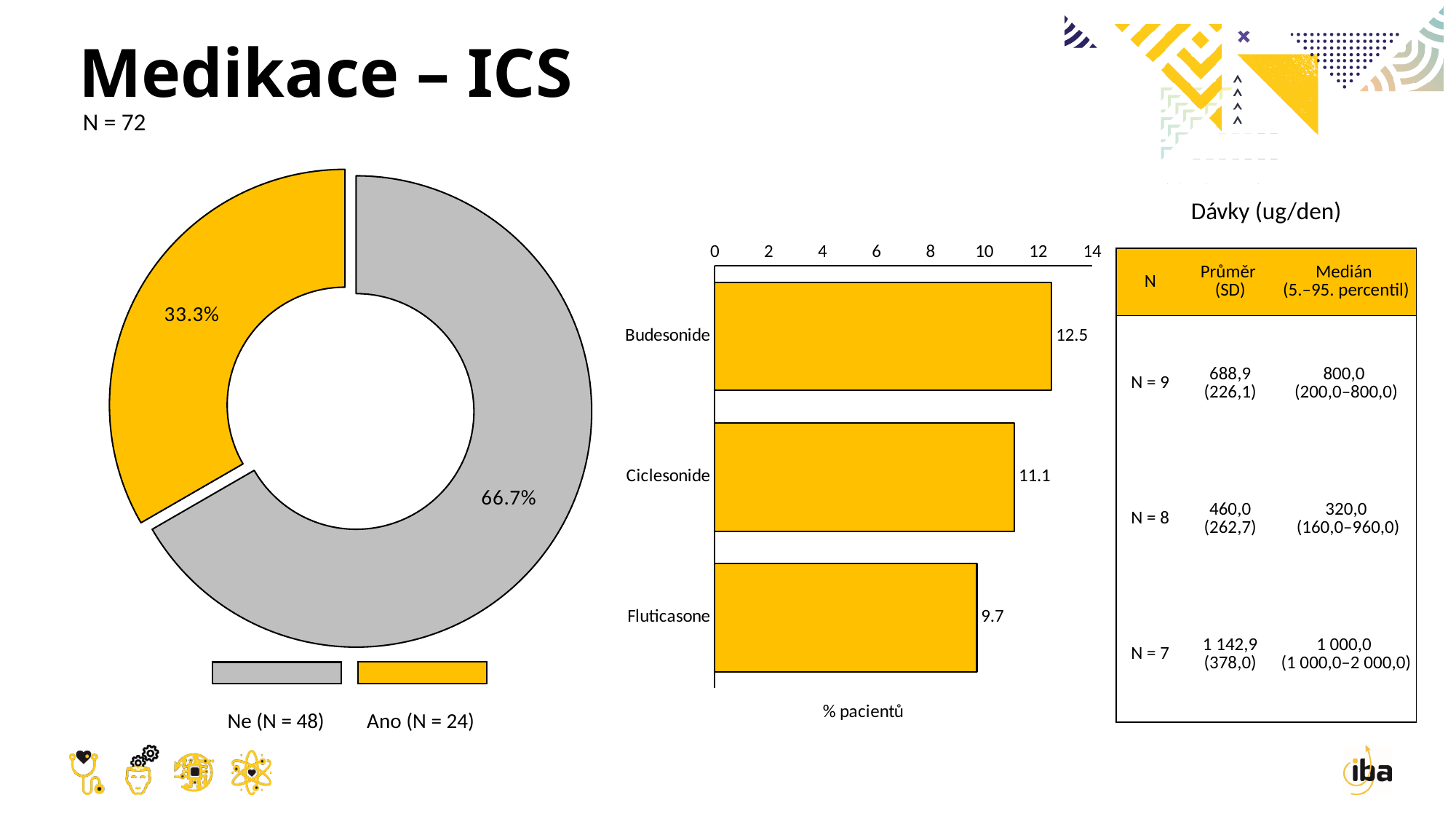
In the donut chart on the left, which slice is larger, 'Ne' or 'Ano'? Ne In the bar chart in the middle, what is the value for Fluticasone? 9.7 In the bar chart in the middle, what is the difference between the values for Budesonide and Fluticasone? 2.8 What kind of chart is the chart in the middle of the slide? Bar chart In the donut chart on the left, what percentage is shown for the 'Ano (N = 24)' slice? 33.3% In the bar chart in the middle, what is the value for Ciclesonide? 11.1 In the donut chart on the left, what percentage is shown for the 'Ne (N = 48)' slice? 66.7% In the donut chart on the left, what colour is the 'Ano' slice? Yellow In the bar chart in the middle, how many categories are plotted? 3 In the bar chart in the middle, which category has the lowest value? Fluticasone In the bar chart in the middle, which category has the highest value? Budesonide In the bar chart in the middle, what is the value for Budesonide? 12.5